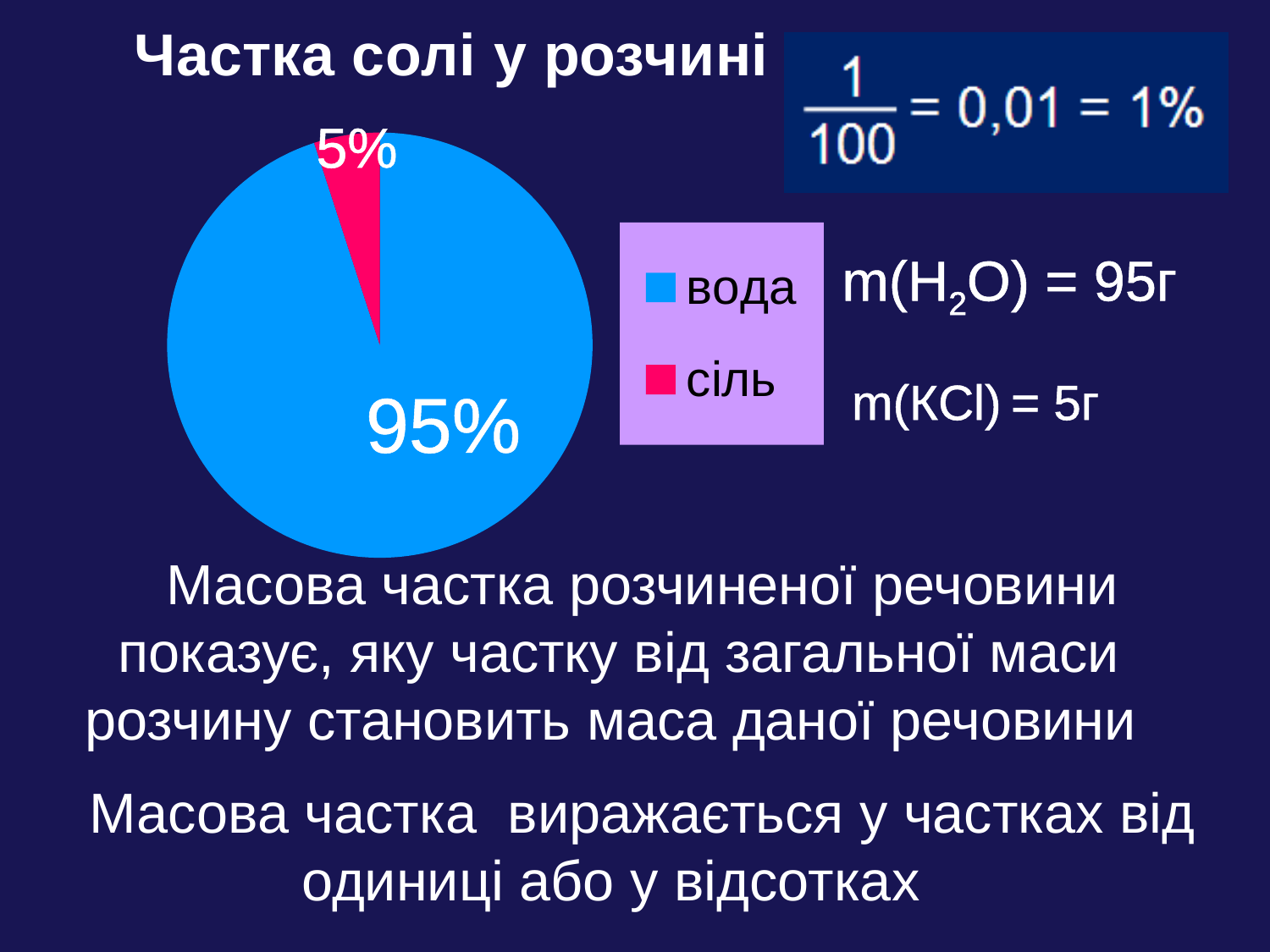
What kind of chart is shown on the slide? pie chart What is the total of the two slices shown in the pie chart? 100% Which is larger, the share for вода or the share for сіль? вода How many slices does the pie chart have? 2 What share of the pie does вода (water) take? 95% What is the title of the chart? Частка солі у розчині What colour is the сіль slice in the pie chart? pink/magenta Which slice of the pie is the smallest? сіль What is the difference in percentage points between the вода slice and the сіль slice? 90% Which slice of the pie is the largest? вода How many entries does the legend list? 2 What share of the pie does сіль (salt) take? 5%